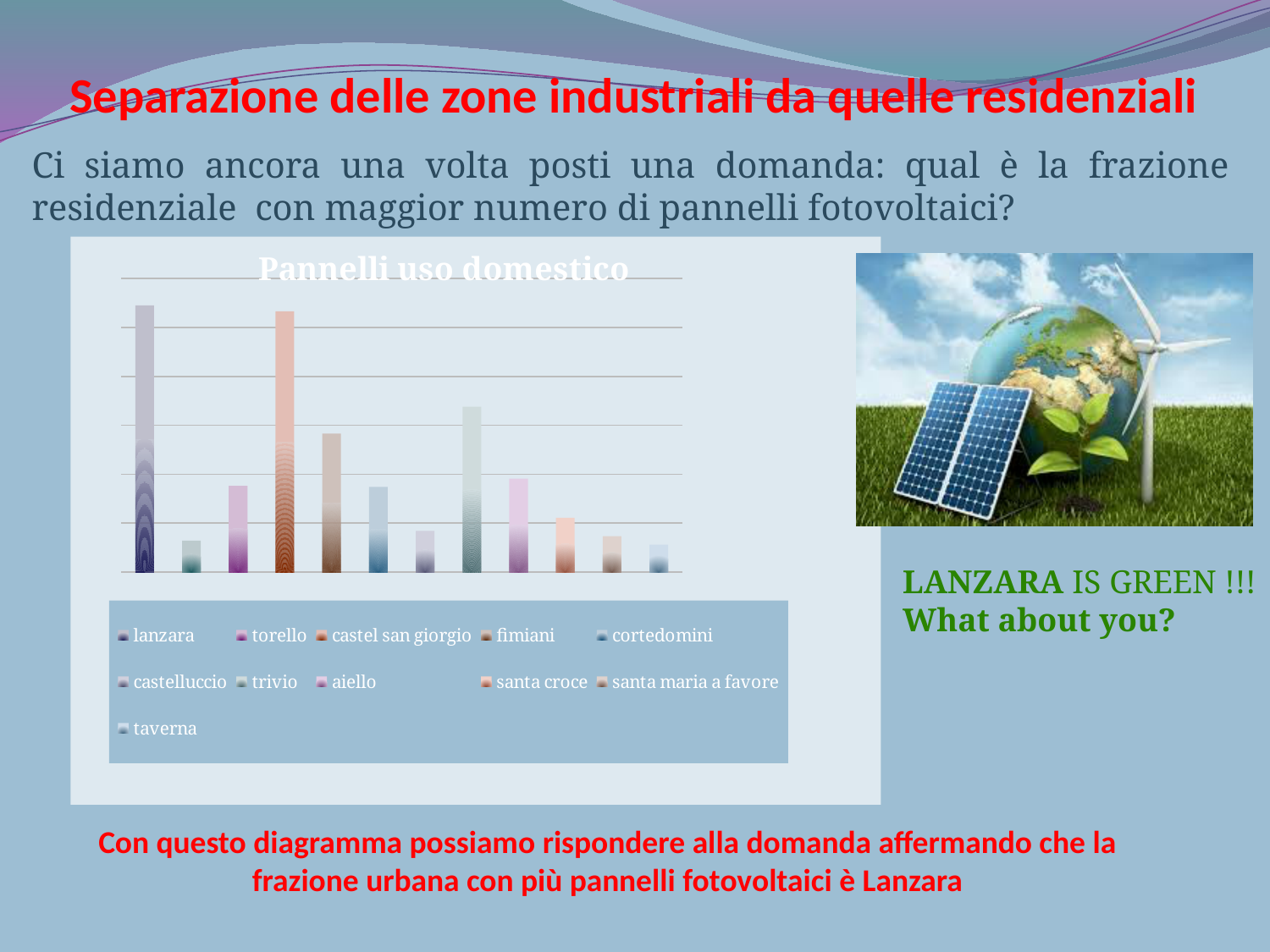
How many bars are plotted in the chart? 12 Which has the larger value, lanzara or fimiani? lanzara Which category has the highest value in the chart? lanzara What is the title of the chart? Pannelli uso domestico Which entry appears first in the chart legend? lanzara What kind of chart is shown on the slide? bar chart How many entries does the chart legend list? 11 Which has the larger value, lanzara or torello? lanzara